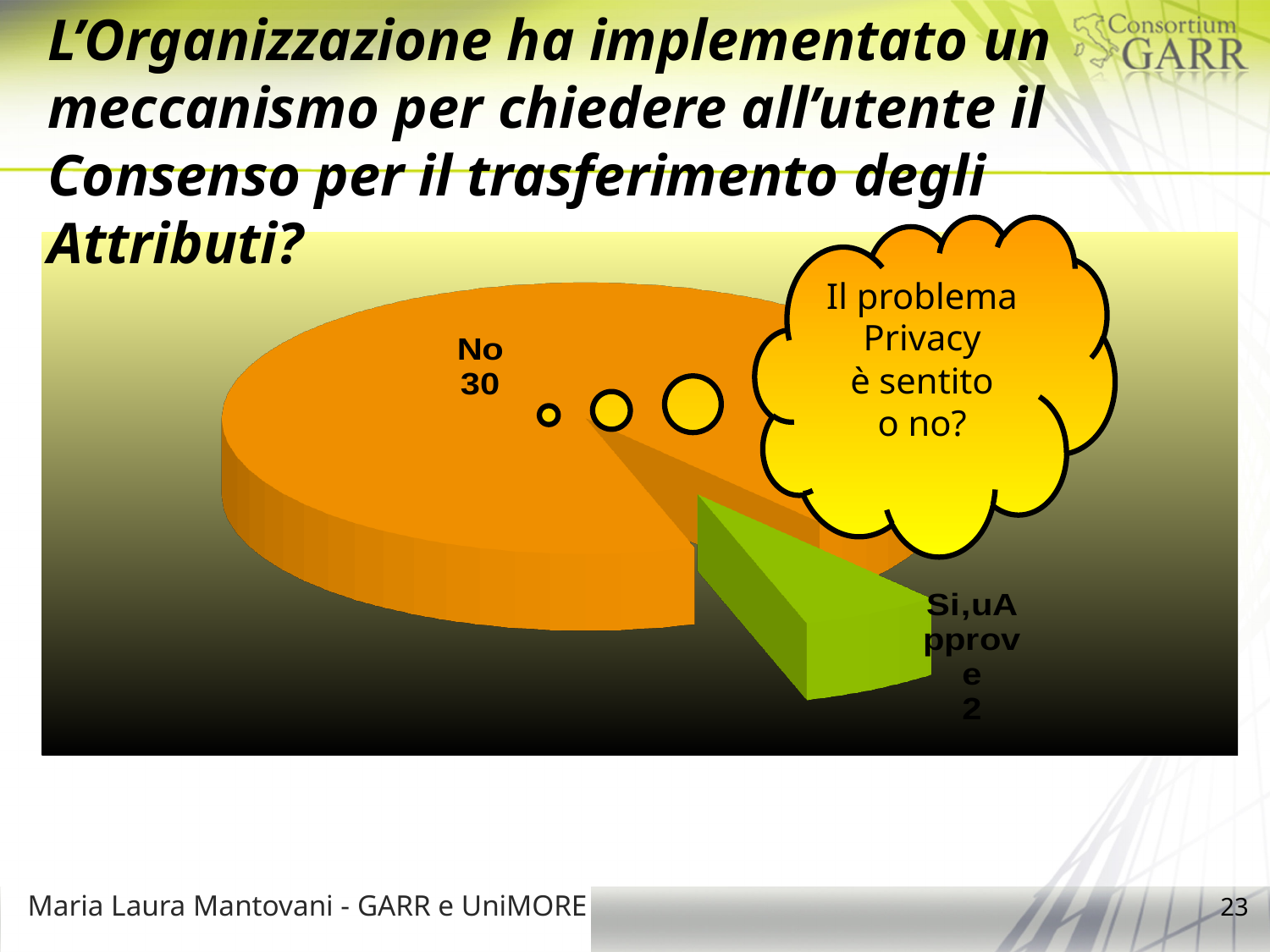
Which is larger in the pie chart, "No" or "Si, uApprove"? No What colour is the "No" slice in the pie chart? orange What colour is the "Si, uApprove" slice in the pie chart? green What is the value of the "Si, uApprove" slice in the pie chart? 2 What is the value of the "No" slice in the pie chart? 30 What is the difference between the "No" value and the "Si, uApprove" value in the pie chart? 28 What is the total of all slices in the pie chart? 32 What kind of chart is shown on the slide? pie chart Which slice of the pie chart is the largest? No Which slice of the pie chart is the smallest? Si, uApprove What share of the pie does the "No" slice represent? 93.75% How many slices does the pie chart have? 2